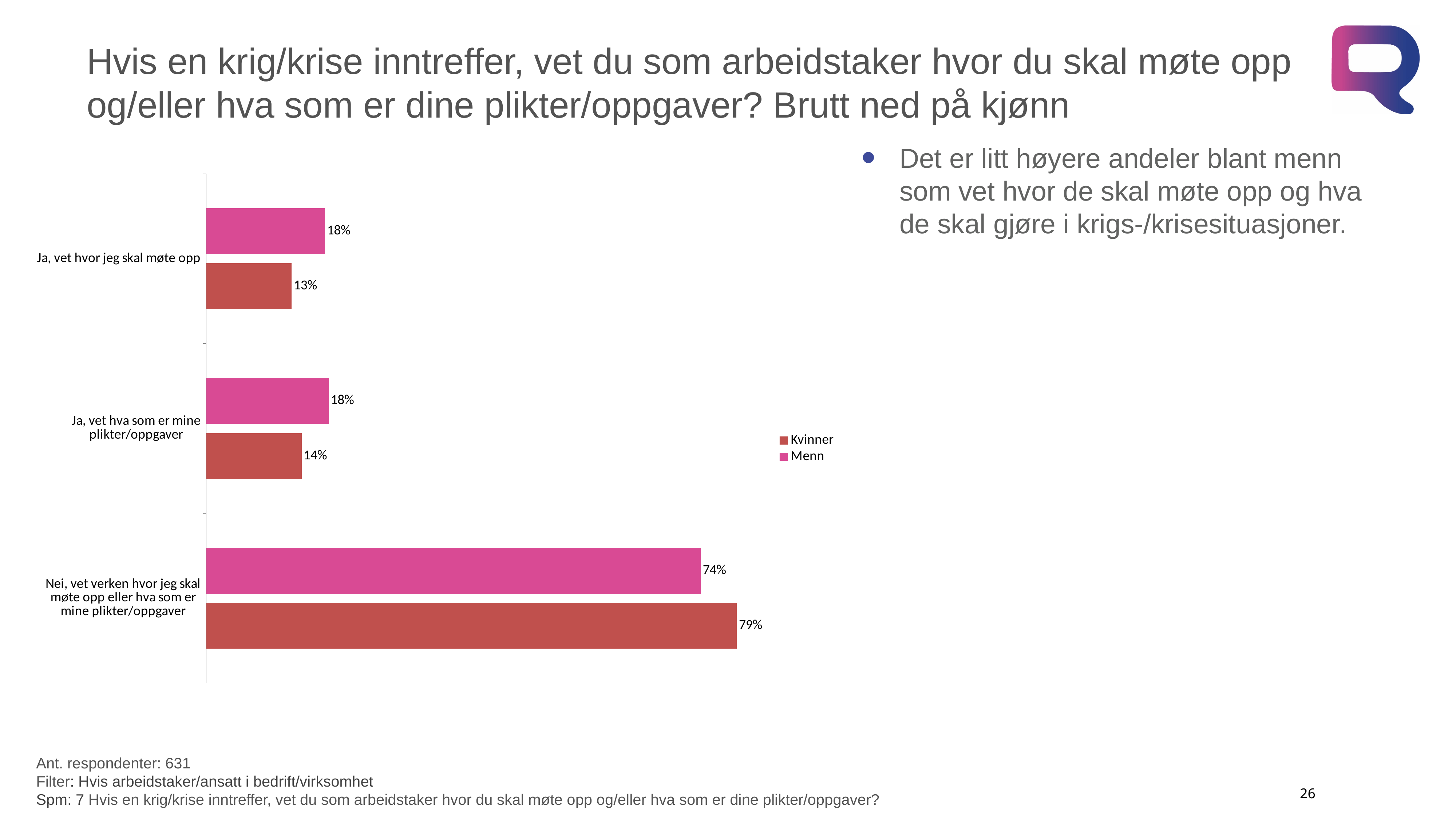
What is the difference between Kvinner and Menn in the category "Nei, vet verken hvor jeg skal møte opp eller hva som er mine plikter/oppgaver"? 5% What is the value for Kvinner in the category "Ja, vet hva som er mine plikter/oppgaver"? 14% Which category has the lowest value for Kvinner? Ja, vet hvor jeg skal møte opp In the category "Ja, vet hva som er mine plikter/oppgaver", which series has the larger value, Kvinner or Menn? Menn What is the value for Menn in the category "Nei, vet verken hvor jeg skal møte opp eller hva som er mine plikter/oppgaver"? 74% What kind of chart is shown on the slide? Bar chart How many categories are shown on the chart? 3 Which category has the highest value for Kvinner? Nei, vet verken hvor jeg skal møte opp eller hva som er mine plikter/oppgaver What is the value for Kvinner in the category "Ja, vet hvor jeg skal møte opp"? 13% What is the value for Menn in the category "Ja, vet hvor jeg skal møte opp"? 18% What is the value for Kvinner in the category "Nei, vet verken hvor jeg skal møte opp eller hva som er mine plikter/oppgaver"? 79% How many series does the legend list? 2